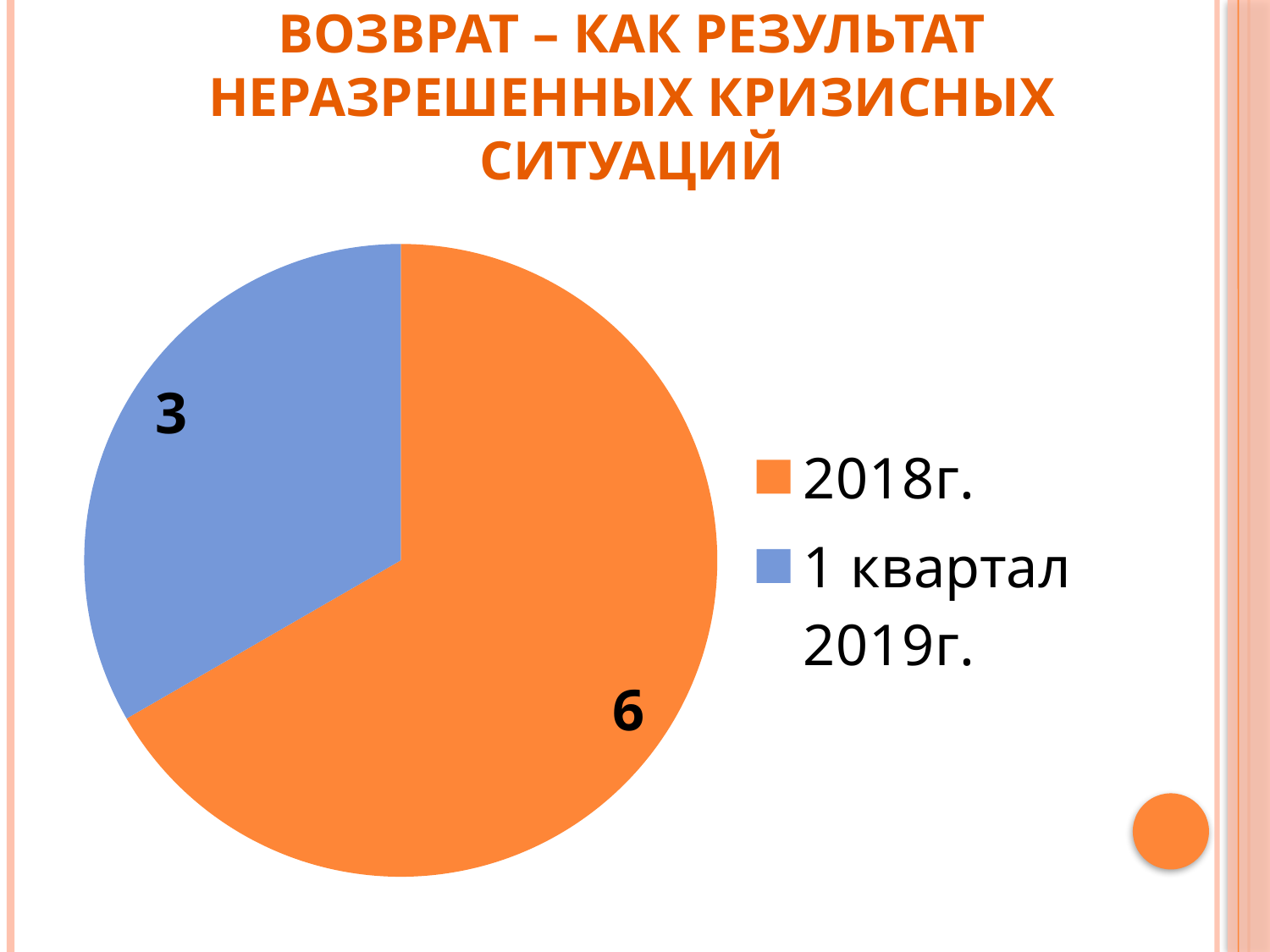
How many slices does the pie chart have? 2 What share of the pie does the 1 квартал 2019г. slice represent? one third What kind of chart is shown on the slide? pie chart What colour is the slice for 2018г.? orange What is the value for 1 квартал 2019г.? 3 Which category has the largest slice? 2018г. What is the total of all slices in the pie chart? 9 What is the value for 2018г.? 6 What is the difference between the values for 2018г. and 1 квартал 2019г.? 3 Which is larger, the value for 2018г. or for 1 квартал 2019г.? 2018г. Which category has the smallest slice? 1 квартал 2019г. How many entries does the legend list? 2